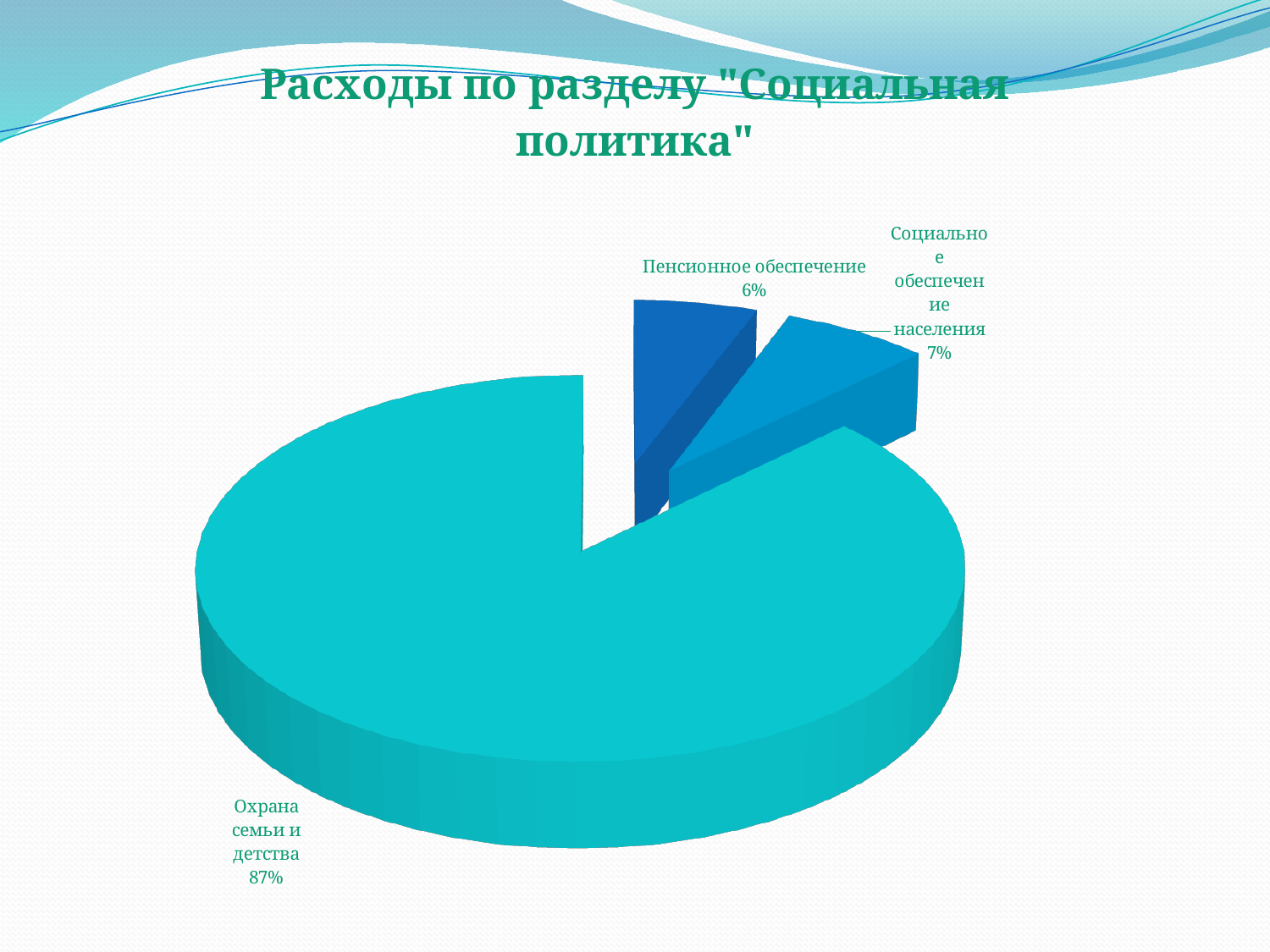
Which is larger: the share for "Социальное обеспечение населения" or for "Пенсионное обеспечение"? Социальное обеспечение населения What is the difference in percentage points between "Социальное обеспечение населения" and "Пенсионное обеспечение"? 1 What is the title of the slide? Расходы по разделу "Социальная политика" What kind of chart is shown on the slide? Pie chart What is the difference in percentage points between "Охрана семьи и детства" and "Социальное обеспечение населения"? 80 Which category has the largest slice of the pie? Охрана семьи и детства How many categories are shown in the pie chart? 3 What share of the pie does "Социальное обеспечение населения" have? 7% What share of the pie does "Охрана семьи и детства" have? 87% What share of the pie does "Пенсионное обеспечение" have? 6% Which category has the smallest slice of the pie? Пенсионное обеспечение What is the combined share of "Пенсионное обеспечение" and "Социальное обеспечение населения"? 13%